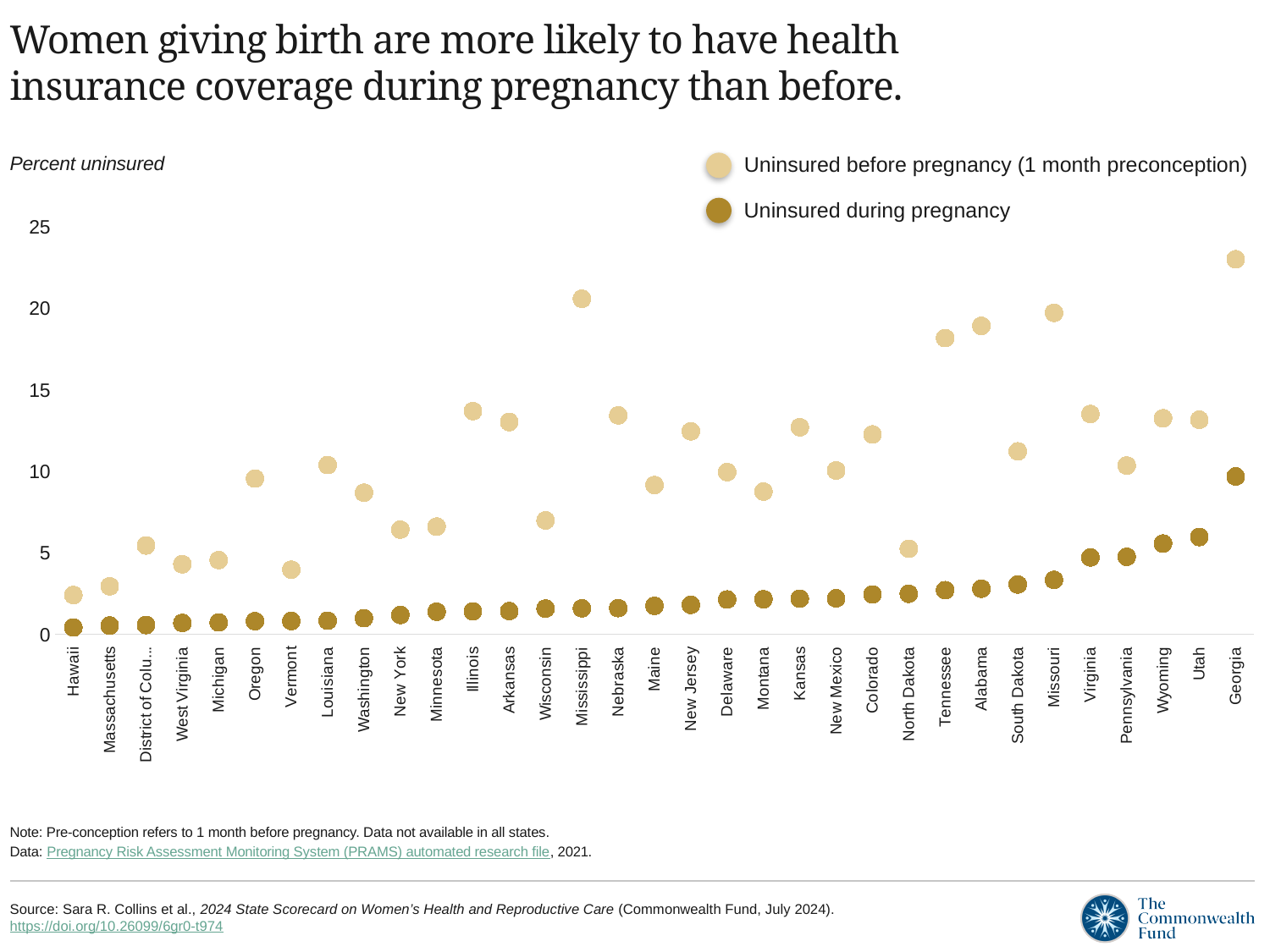
Is the value for uninsured before pregnancy in Tennessee greater or less than 20? less Is the value for uninsured before pregnancy in Illinois greater or less than 10? greater How many series does the legend list? 2 Which state has the highest value for uninsured during pregnancy? Georgia Is the value for uninsured before pregnancy in Hawaii greater or less than 5? less Do the values for uninsured during pregnancy generally rise or fall from left to right along the x axis? rise What is the label of the y axis? Percent uninsured Which state has the highest value for uninsured before pregnancy? Georgia Which is larger: uninsured before pregnancy in Mississippi or in Illinois? Mississippi What kind of chart is shown on the slide? Dot plot How many states or jurisdictions are plotted along the x axis? 33